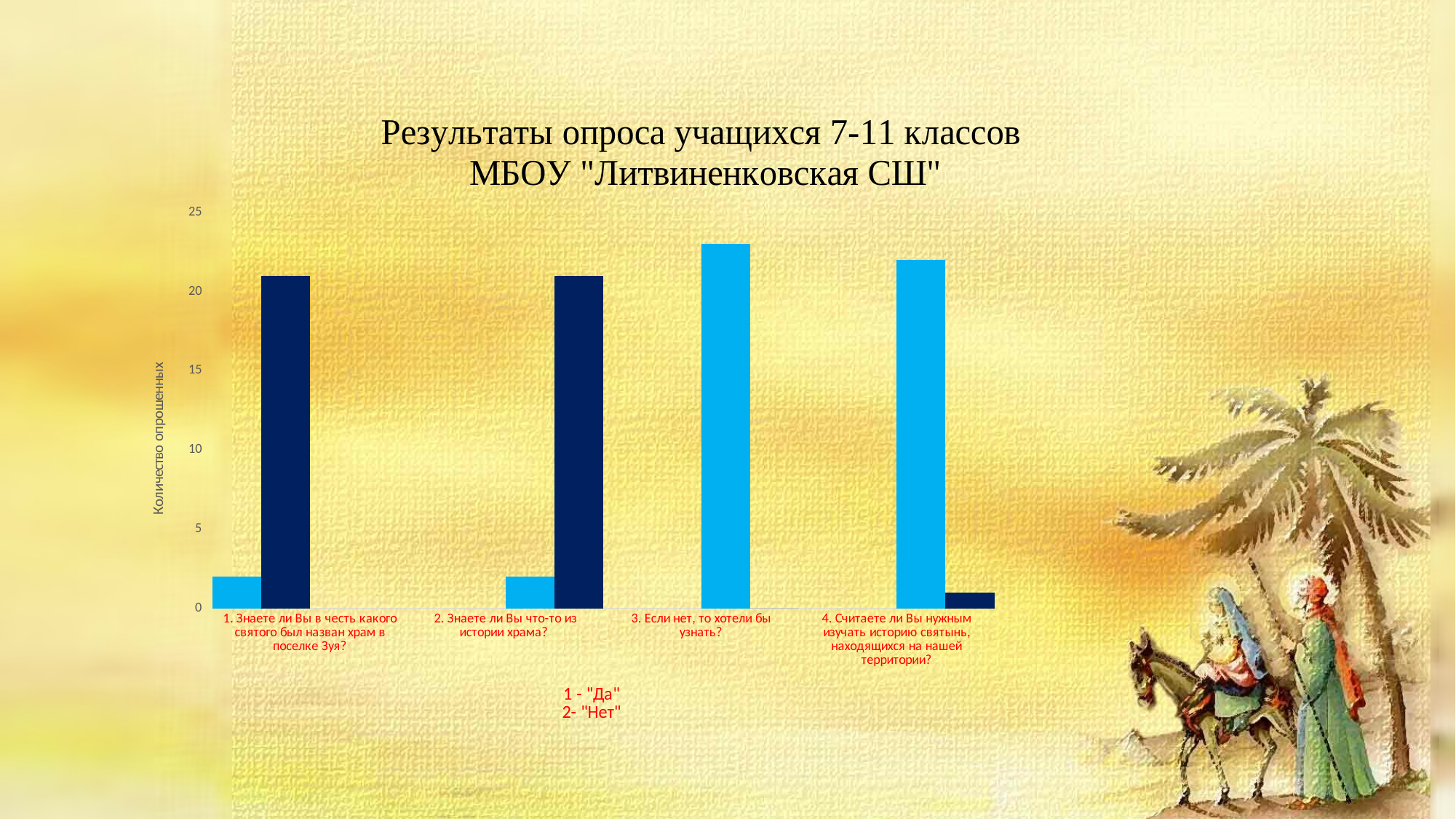
What is the title of the chart? Результаты опроса учащихся 7-11 классов МБОУ "Литвиненковская СШ" How many survey questions (categories) are shown along the x axis of the chart? 4 Which is larger: the "Да" bar for question 3 ("Если нет, то хотели бы узнать?") or the "Да" bar for question 2 ("Знаете ли Вы что-то из истории храма?")? question 3 For question 4 ("Считаете ли Вы нужным изучать историю святынь, находящихся на нашей территории?"), which answer has the larger bar, "Да" or "Нет"? Да Is the value of the "Да" bar for question 4 ("Считаете ли Вы нужным изучать историю святынь, находящихся на нашей территории?") greater or less than 15? greater Is the value of the "Да" bar for question 1 ("Знаете ли Вы в честь какого святого был назван храм в поселке Зуя?") greater or less than 5? less What is the label of the vertical axis of the chart? Количество опрошенных For question 1 ("Знаете ли Вы в честь какого святого был назван храм в поселке Зуя?"), which answer has the larger bar, "Да" or "Нет"? Нет Is the value of the "Нет" bar for question 4 ("Считаете ли Вы нужным изучать историю святынь, находящихся на нашей территории?") greater or less than 5? less What kind of chart is shown on the slide? bar chart